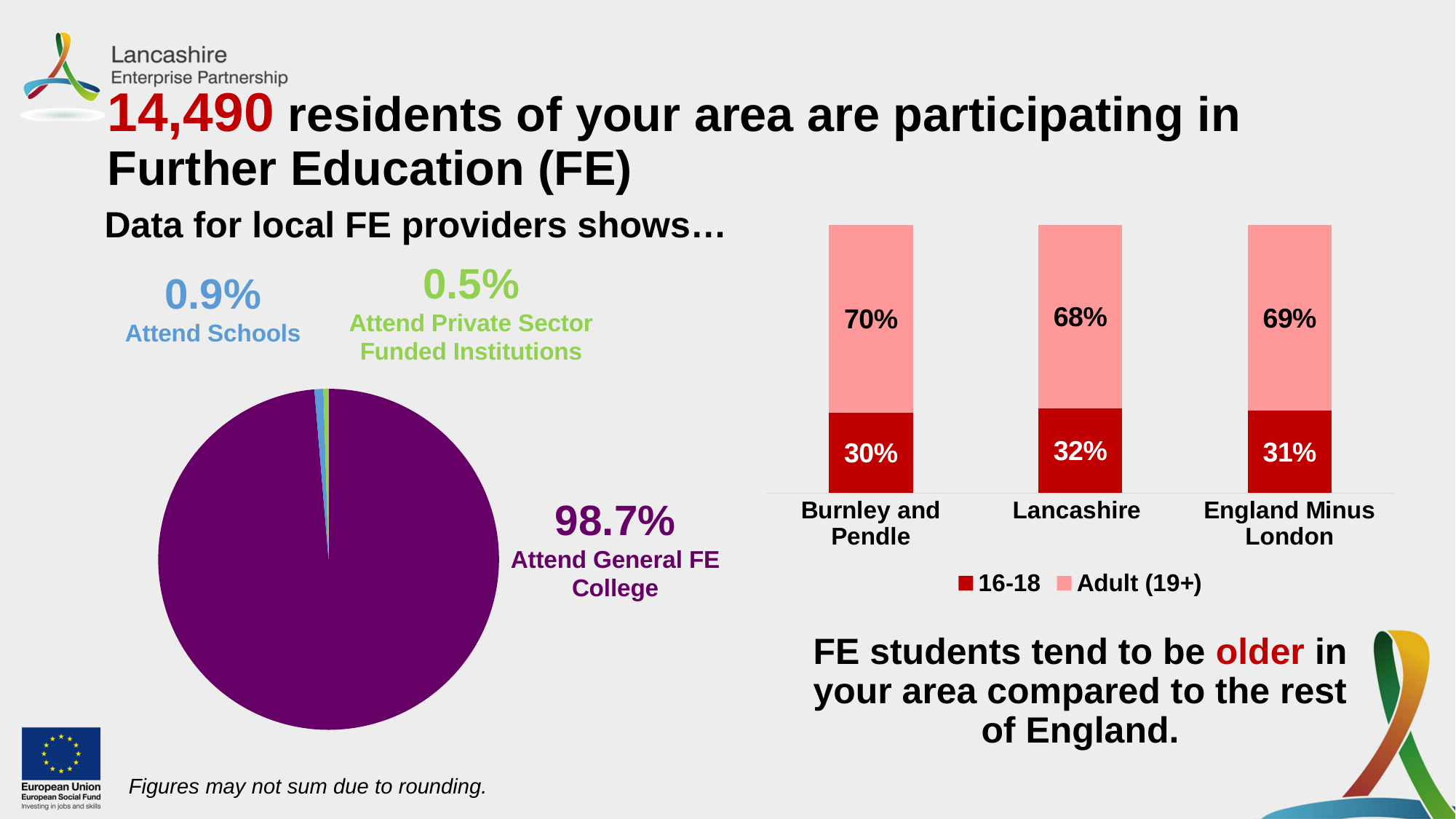
In the stacked bar chart on the right of the slide, what is the difference between the Adult (19+) values for Burnley and Pendle and Lancashire? 2% In the pie chart on the left of the slide, what share of FE participants attend a General FE College? 98.7% In the pie chart on the left of the slide, what percentage attend private sector funded institutions? 0.5% How many slices does the pie chart on the left of the slide have? 3 How many series does the legend of the stacked bar chart on the right of the slide list? 2 In the pie chart on the left of the slide, which category has the smallest share? Attend Private Sector Funded Institutions In the stacked bar chart on the right of the slide, which area has the highest 16-18 share? Lancashire What type of chart is shown on the right of the slide? Stacked bar chart In the stacked bar chart on the right of the slide, what is the Adult (19+) value for England Minus London? 69% In the stacked bar chart on the right of the slide, what is the Adult (19+) value for Lancashire? 68% In the stacked bar chart on the right of the slide, what is the 16-18 value for Burnley and Pendle? 30% In the pie chart on the left of the slide, what percentage attend schools? 0.9%